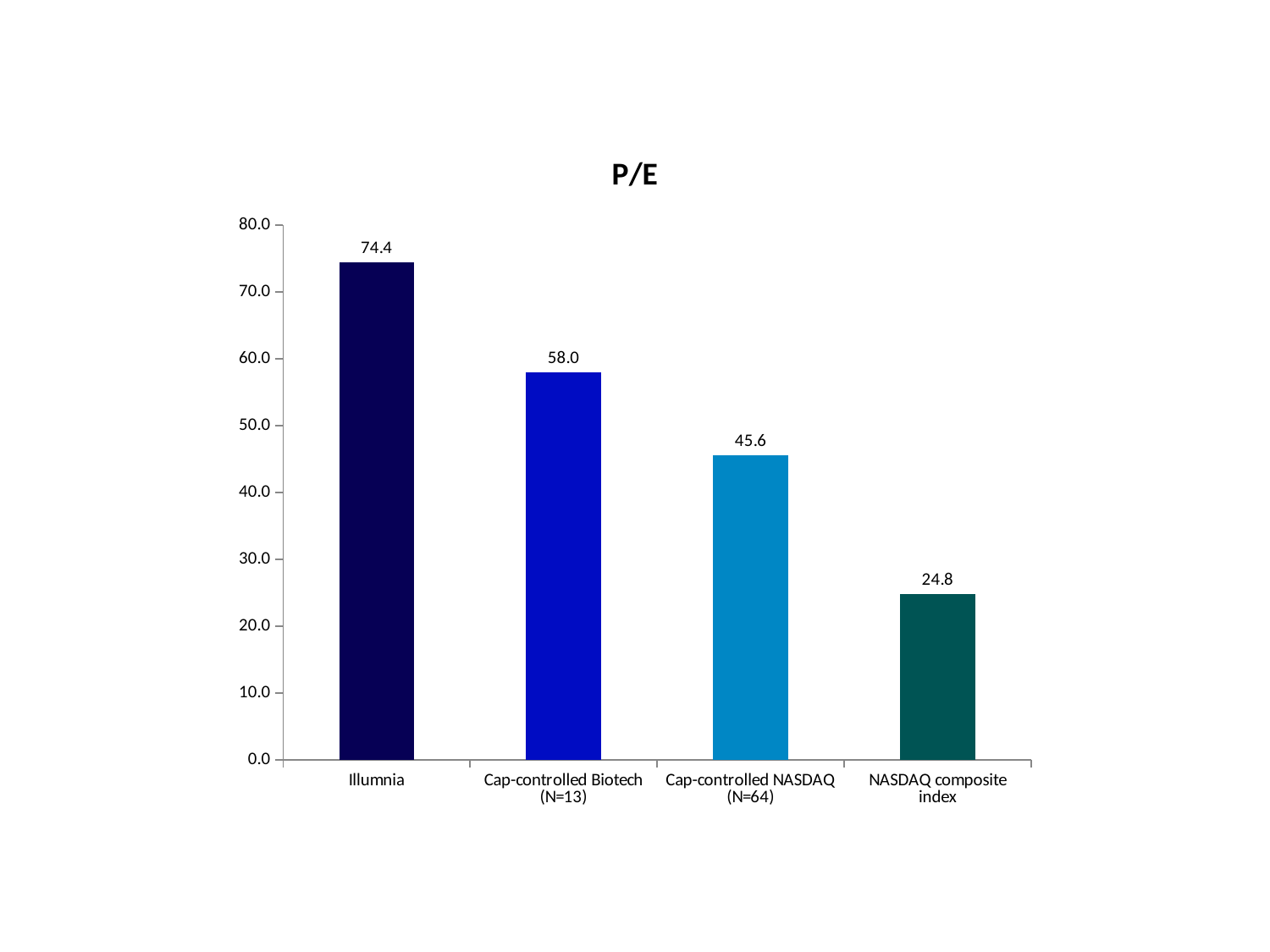
Which category has the highest P/E? Illumnia Do the values rise or fall from left to right across the categories? Fall Which has a larger P/E, Cap-controlled Biotech (N=13) or Cap-controlled NASDAQ (N=64)? Cap-controlled Biotech (N=13) What is the P/E value for the NASDAQ composite index? 24.8 What is the difference between the P/E of Cap-controlled Biotech (N=13) and Cap-controlled NASDAQ (N=64)? 12.4 How many categories are shown in the chart? 4 What kind of chart is this? Bar chart What is the P/E value for Illumnia? 74.4 What is the P/E value for Cap-controlled NASDAQ (N=64)? 45.6 What is the difference between the P/E of Illumnia and the NASDAQ composite index? 49.6 What is the P/E value for Cap-controlled Biotech (N=13)? 58.0 Which category has the lowest P/E? NASDAQ composite index